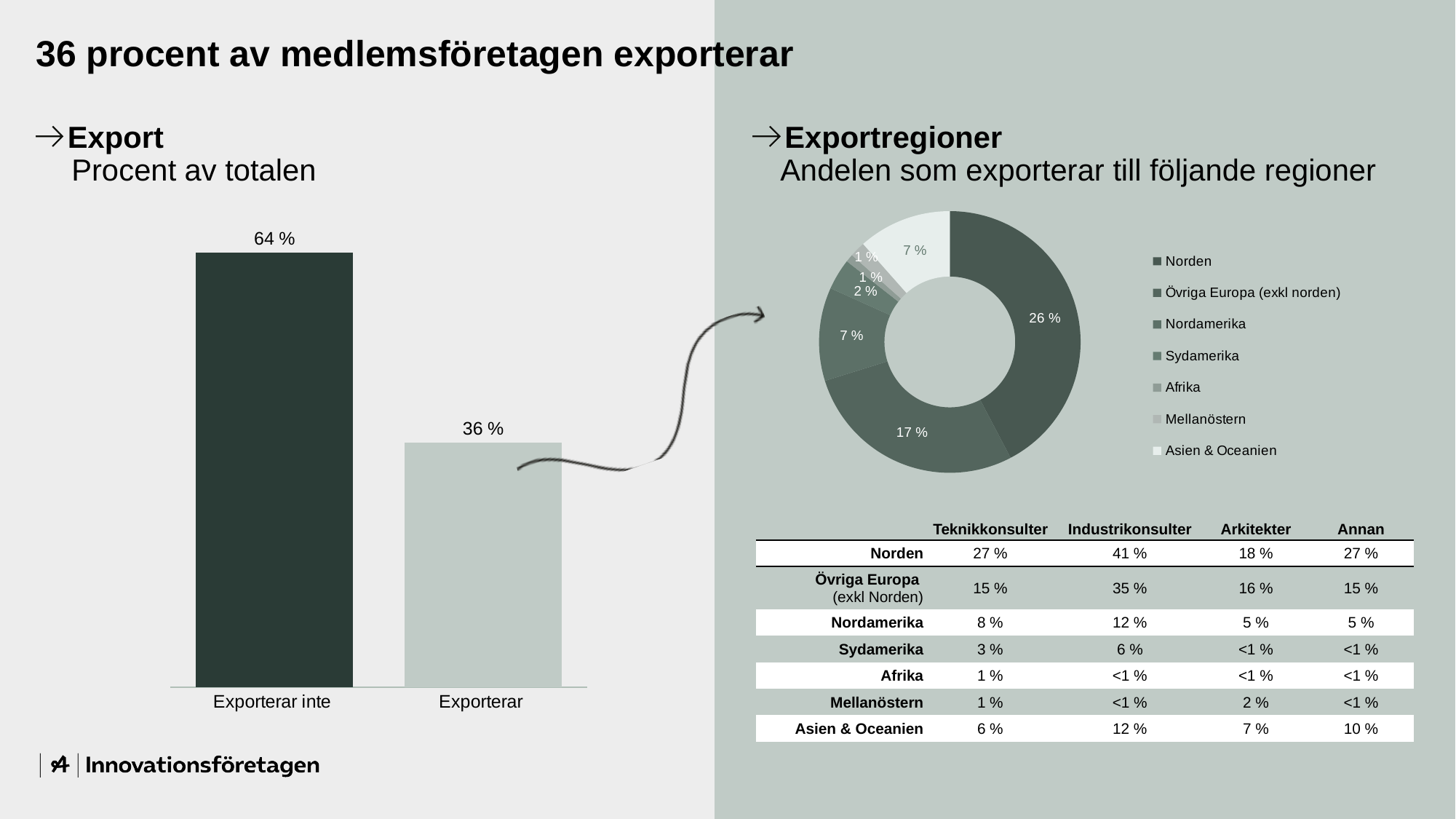
In the Exportregioner chart, what share is labelled for Norden? 26 % What kind of chart is the Exportregioner chart? Doughnut chart What kind of chart is the Export chart on the left? Bar chart In the Export bar chart, what is the value for Exporterar? 36 % In the Export bar chart, what is the difference between Exporterar inte and Exporterar? 28 % In the Exportregioner chart, how many regions does the legend list? 7 In the Exportregioner chart, what share is labelled for Övriga Europa (exkl norden)? 17 % In the Export bar chart, which category has the higher value? Exporterar inte In the Export bar chart, what is the value for Exporterar inte? 64 % In the Exportregioner chart, which is larger: Norden or Övriga Europa (exkl norden)? Norden In the Exportregioner chart, which region has the largest slice? Norden In the Export bar chart, how many bars are shown? 2